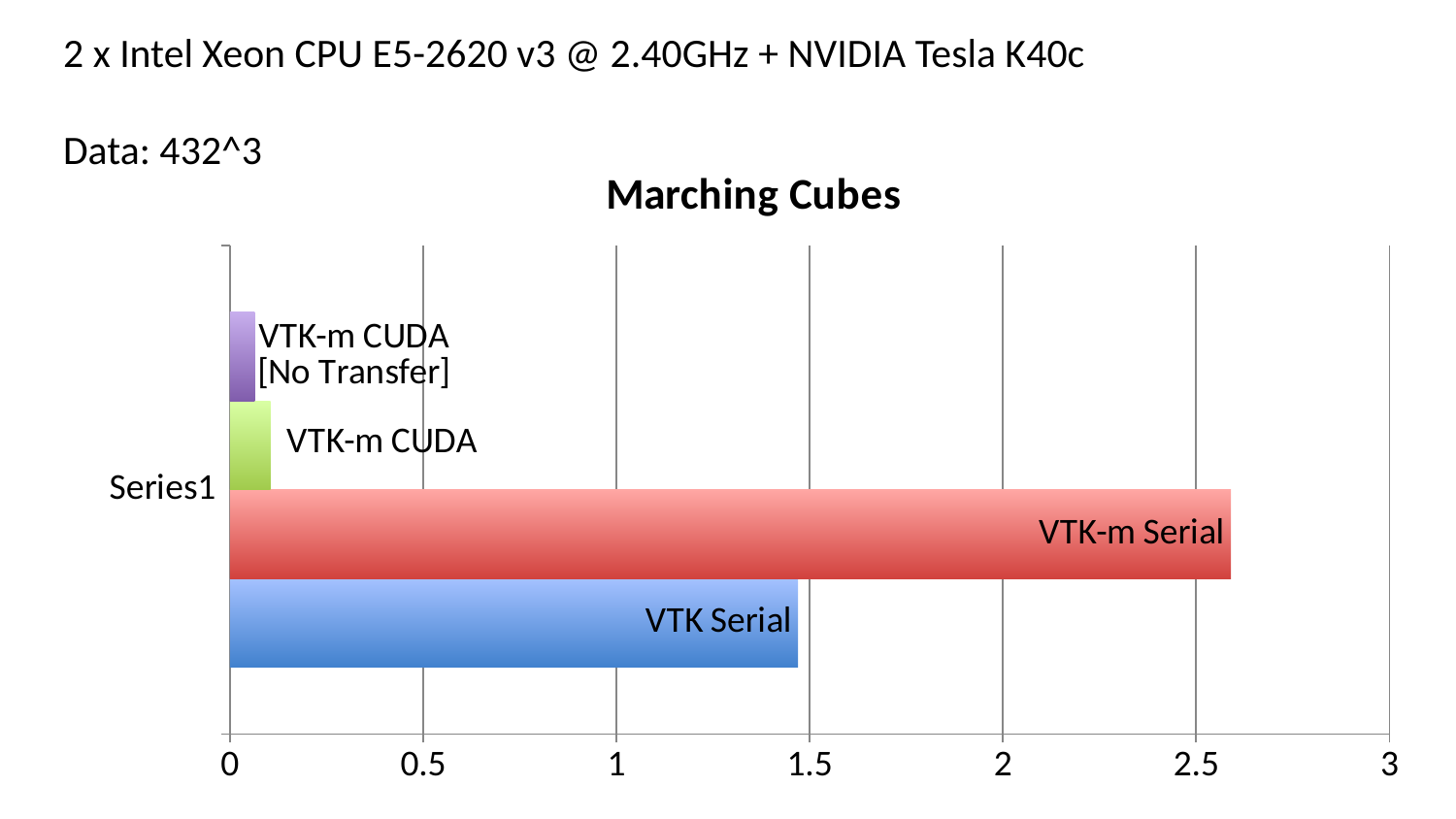
Is the value for VTK-m Serial greater or less than 2.5? greater Which bar has the highest value? VTK-m Serial What kind of chart is shown on the slide? bar chart Which is larger, VTK-m CUDA or VTK-m CUDA [No Transfer]? VTK-m CUDA What is the title of the chart? Marching Cubes Is the value for VTK Serial greater or less than 1.5? less Is the value for VTK-m CUDA greater or less than 0.5? less Which bar has the lowest value? VTK-m CUDA [No Transfer] How many bars are plotted in the chart? 4 Which is larger, VTK Serial or VTK-m Serial? VTK-m Serial What is the highest value shown on the horizontal axis? 3